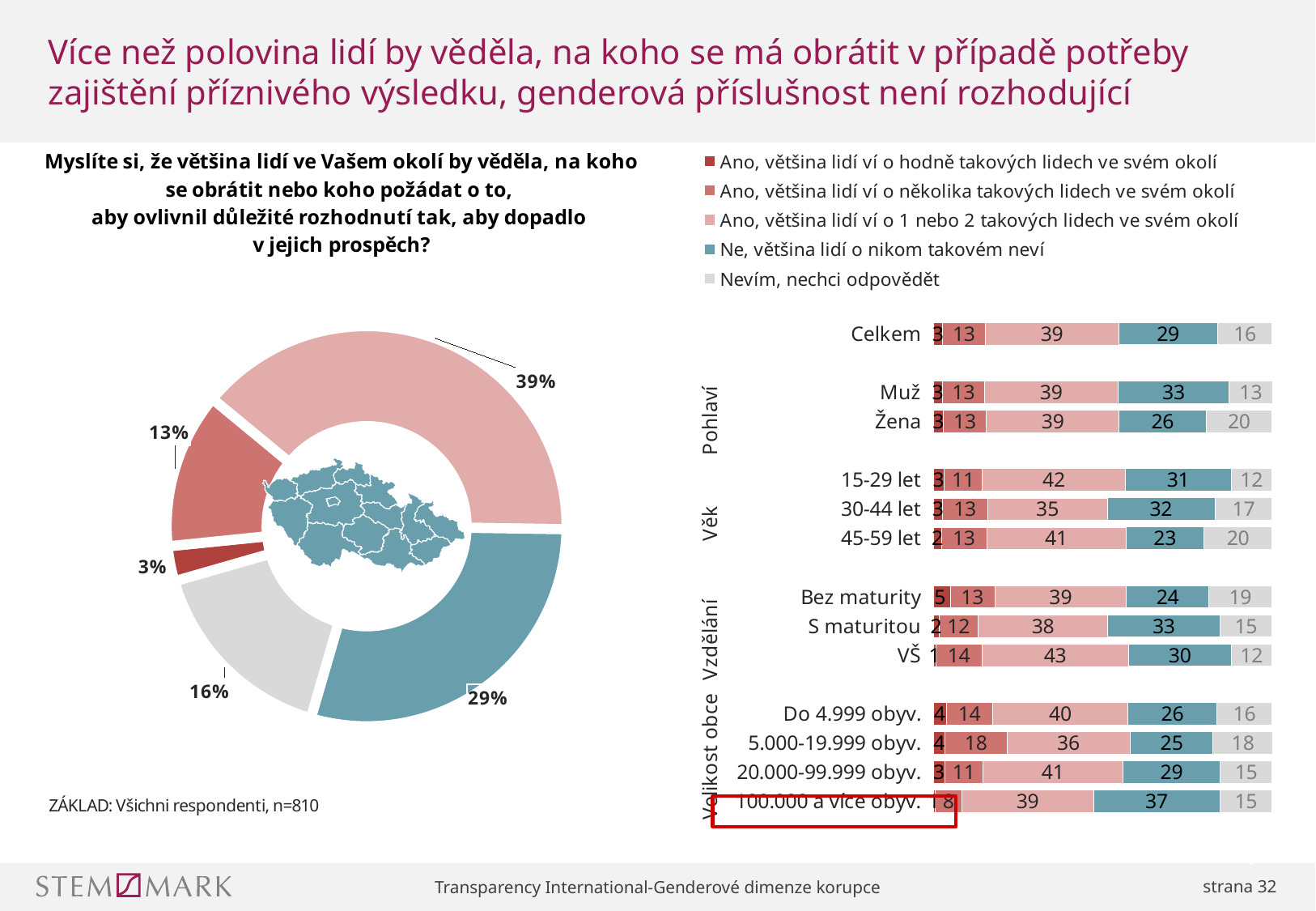
In the bar chart on the right, what is the value of 'Ne, většina lidí o nikom takovém neví' for Muž? 33 In the bar chart on the right, what is the difference between Muž and Žena for 'Ne, většina lidí o nikom takovém neví'? 7 What kind of chart is the chart on the left side of the slide? doughnut chart What kind of chart is the chart on the right side of the slide? bar chart How many slices does the pie chart on the left have? 5 In the bar chart on the right, which has the larger value for 'Ano, většina lidí ví o několika takových lidech ve svém okolí': Do 4.999 obyv. or 5.000-19.999 obyv.? 5.000-19.999 obyv. In the bar chart on the right, how many series does the legend list? 5 In the bar chart on the right, what is the total of the Celkem bar? 100 In the bar chart on the right, how many categories (rows) are plotted? 13 In the bar chart on the right, what is the value of 'Nevím, nechci odpovědět' for Žena? 20 In the bar chart on the right, which age group has the highest value for 'Ano, většina lidí ví o 1 nebo 2 takových lidech ve svém okolí'? 15-29 let In the pie chart on the left, what share does the largest slice have? 39%